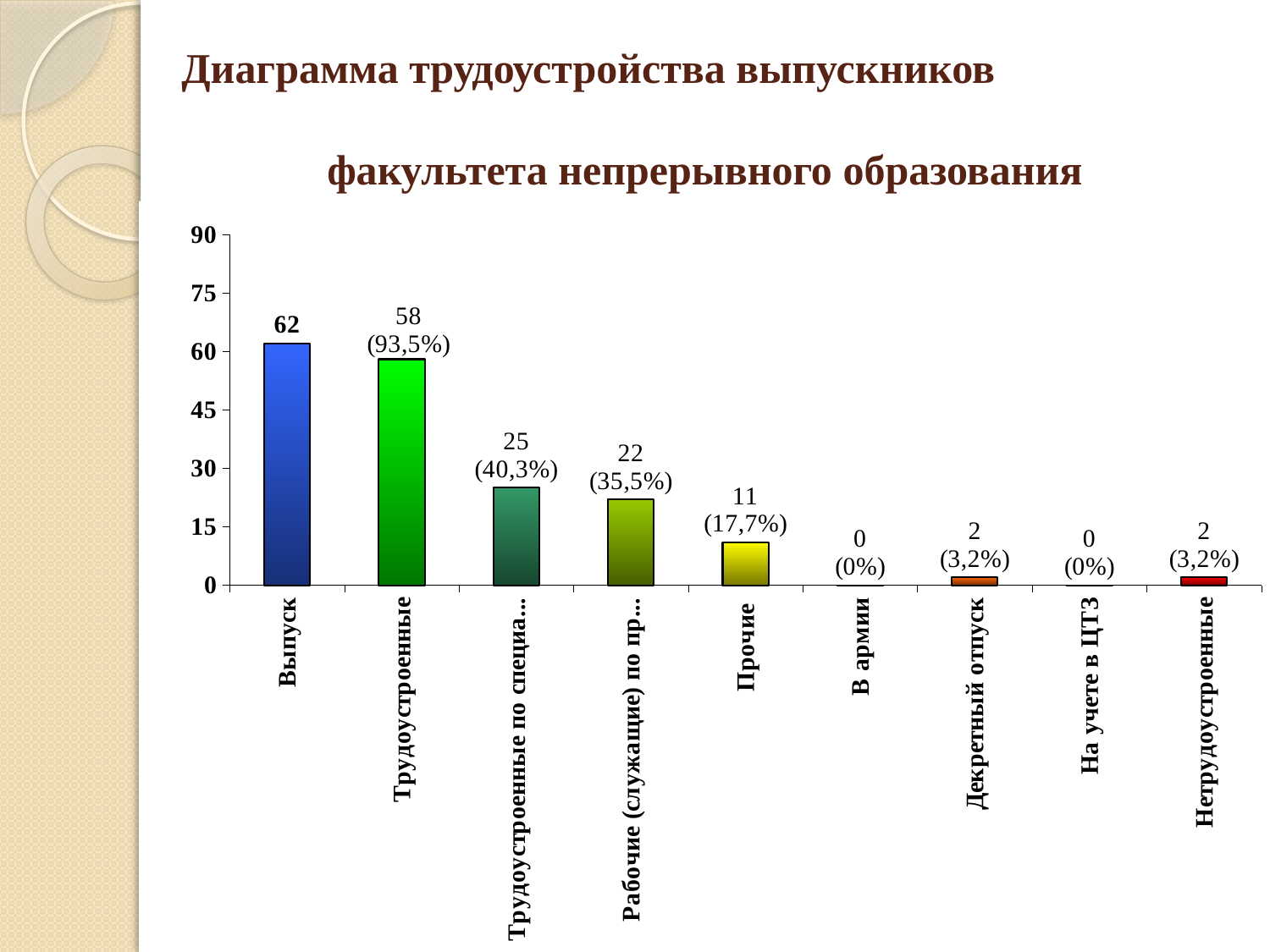
How many categories are shown on the x axis? 9 Which is larger, the value for Прочие or the value for Нетрудоустроенные? Прочие What is the value for Трудоустроенные? 58 What is the value for В армии? 0 What is the highest value shown on the y axis? 90 What percentage is shown for Трудоустроенные? 93,5% What is the difference between the values for Выпуск and Трудоустроенные? 4 What percentage is shown for Декретный отпуск? 3,2% What is the value for Прочие? 11 Which category has the highest value? Выпуск What kind of chart is shown on the slide? Bar chart What is the value for Выпуск? 62